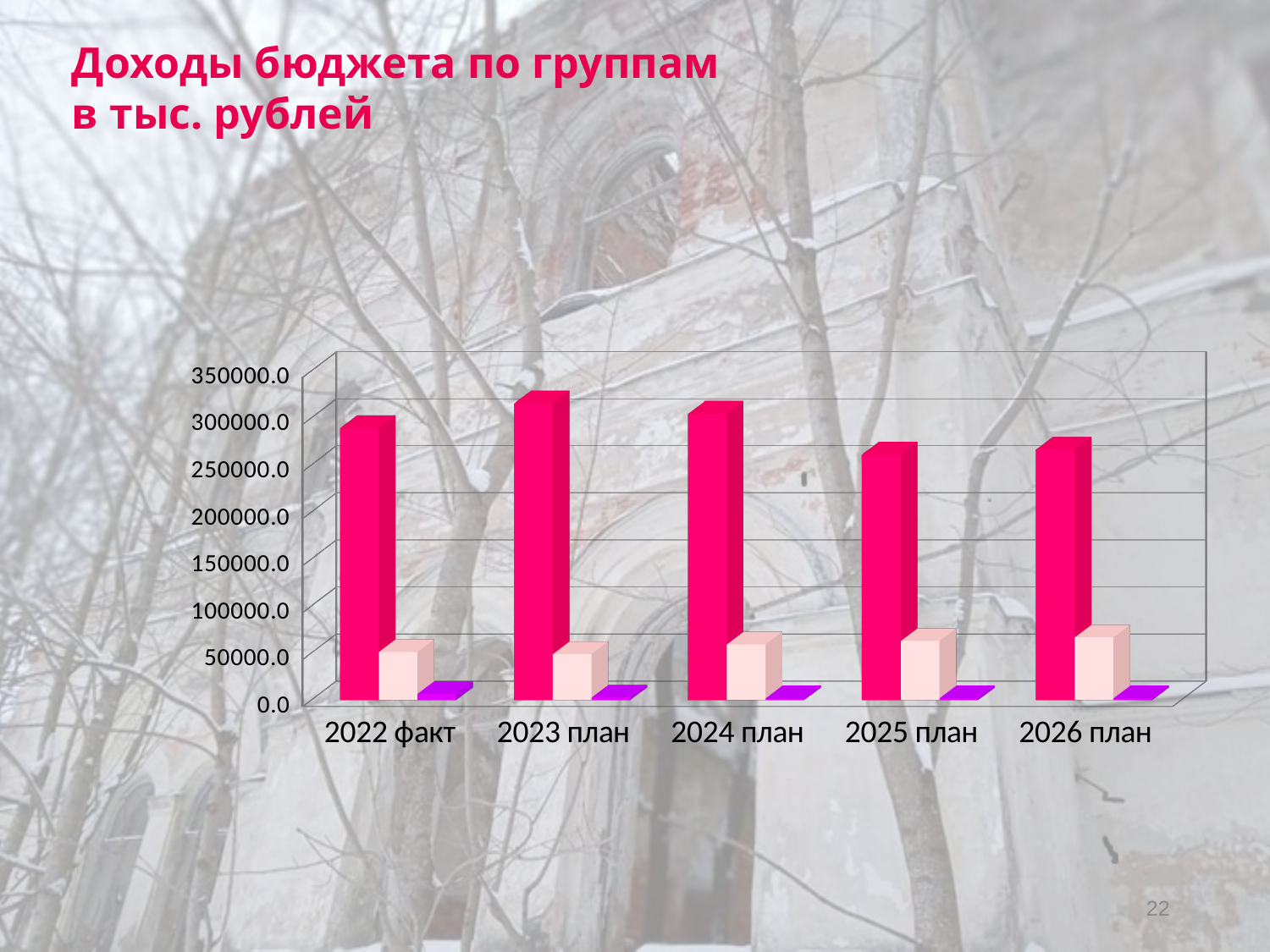
What is the title of the chart on the slide? Доходы бюджета по группам в тыс. рублей How many categories are shown on the x axis of the chart? 5 What kind of chart is shown on the slide? bar chart Is the value of the purple bar for 2024 план greater or less than 50000.0? less Is the value of the tallest (magenta) bar for 2026 план greater or less than 350000.0? less Is the value of the light pink bar for 2022 факт greater or less than 100000.0? less Which has the larger magenta bar: 2022 факт or 2025 план? 2022 факт Which has the larger magenta bar: 2023 план or 2026 план? 2023 план How many bars are shown for each category on the x axis? 3